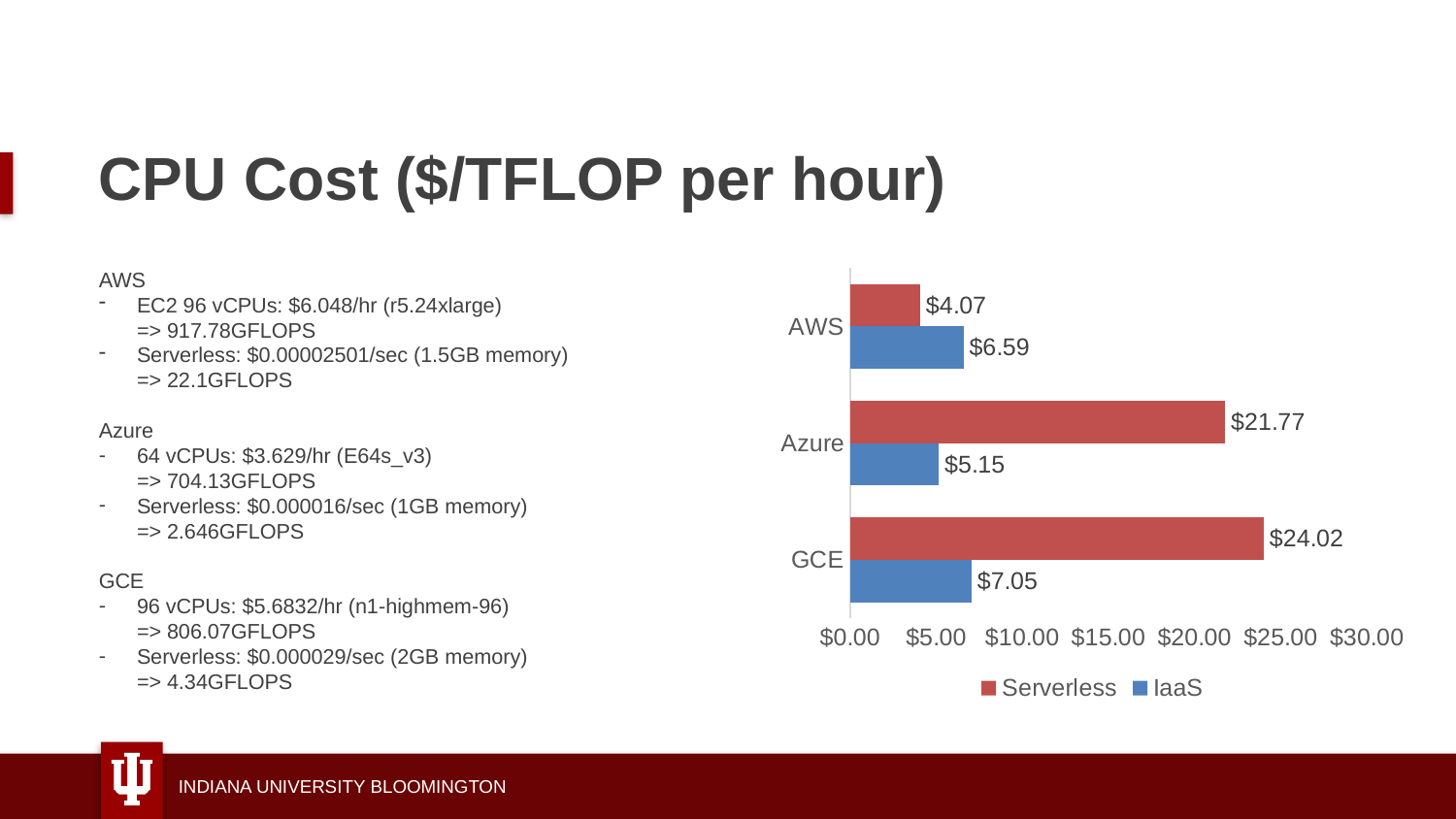
What is the Serverless CPU cost for Azure? $21.77 How many series does the legend list? 2 What is the IaaS CPU cost for GCE? $7.05 Which provider has the lowest IaaS cost? Azure How many providers are shown on the chart? 3 Is the Serverless cost for Azure greater or less than $20.00? greater What is the Serverless CPU cost for AWS? $4.07 Which is larger for AWS, the Serverless cost or the IaaS cost? IaaS What is the difference between the Serverless and IaaS costs for GCE? $16.97 What kind of chart is shown on the slide? bar chart Which provider has the highest Serverless cost? GCE What colour represents the IaaS series in the chart? blue